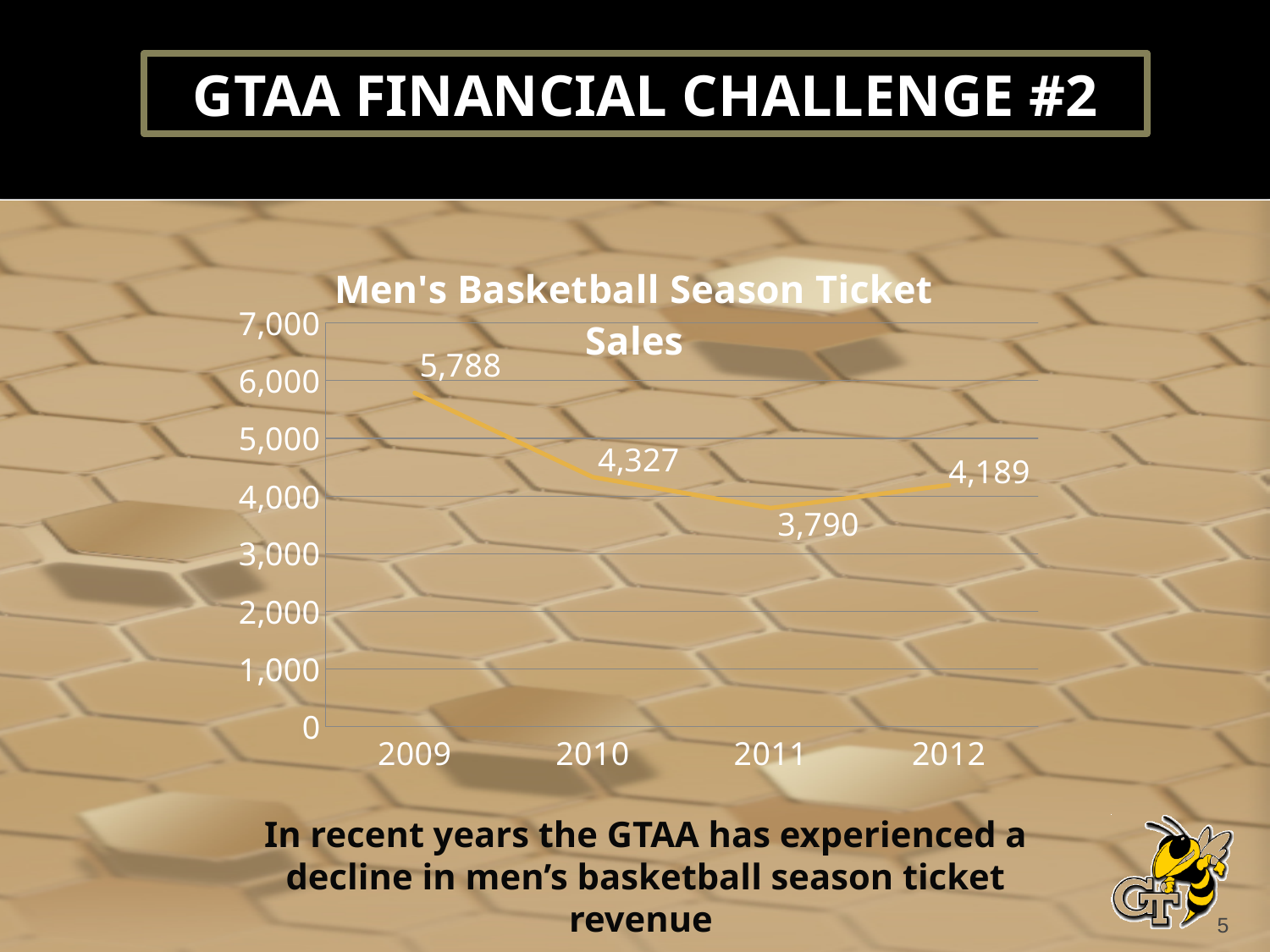
What is the difference in season ticket sales between 2012 and 2011? 399 How many years are plotted on the chart? 4 Is the value for 2011 greater or less than 4,000? less What were men's basketball season ticket sales in 2011? 3,790 What is the title of the chart? Men's Basketball Season Ticket Sales Which year had the lowest men's basketball season ticket sales? 2011 By how much did season ticket sales fall from 2009 to 2010? 1,461 What were men's basketball season ticket sales in 2009? 5,788 What kind of chart is shown on the slide? line chart Which year had the highest men's basketball season ticket sales? 2009 Were season ticket sales higher in 2010 or in 2012? 2010 What were men's basketball season ticket sales in 2012? 4,189